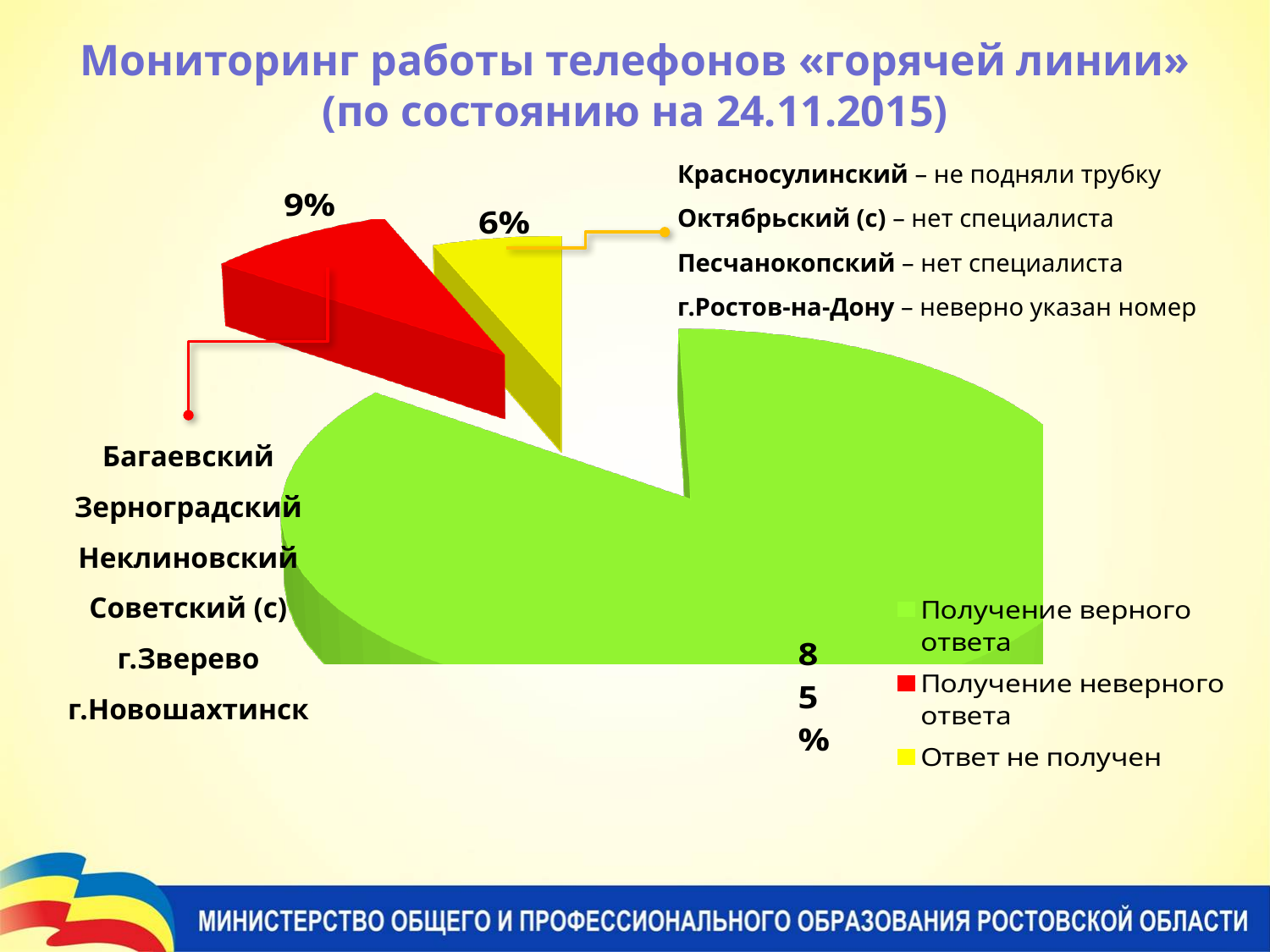
What percentage of the pie is labelled "Получение верного ответа"? 85% How many entries does the legend list? 3 Which is larger: the slice for "Получение неверного ответа" or the slice for "Ответ не получен"? Получение неверного ответа Which category has the smallest slice of the pie? Ответ не получен What kind of chart is shown on the slide? pie chart What percentage of the pie is labelled "Получение неверного ответа"? 9% What is the difference in percentage points between "Получение неверного ответа" and "Ответ не получен"? 3 What colour is the slice for "Ответ не получен"? yellow How many slices does the pie chart have? 3 Which category has the largest slice of the pie? Получение верного ответа What percentage of the pie is labelled "Ответ не получен"? 6% What date is given in the chart's title? 24.11.2015